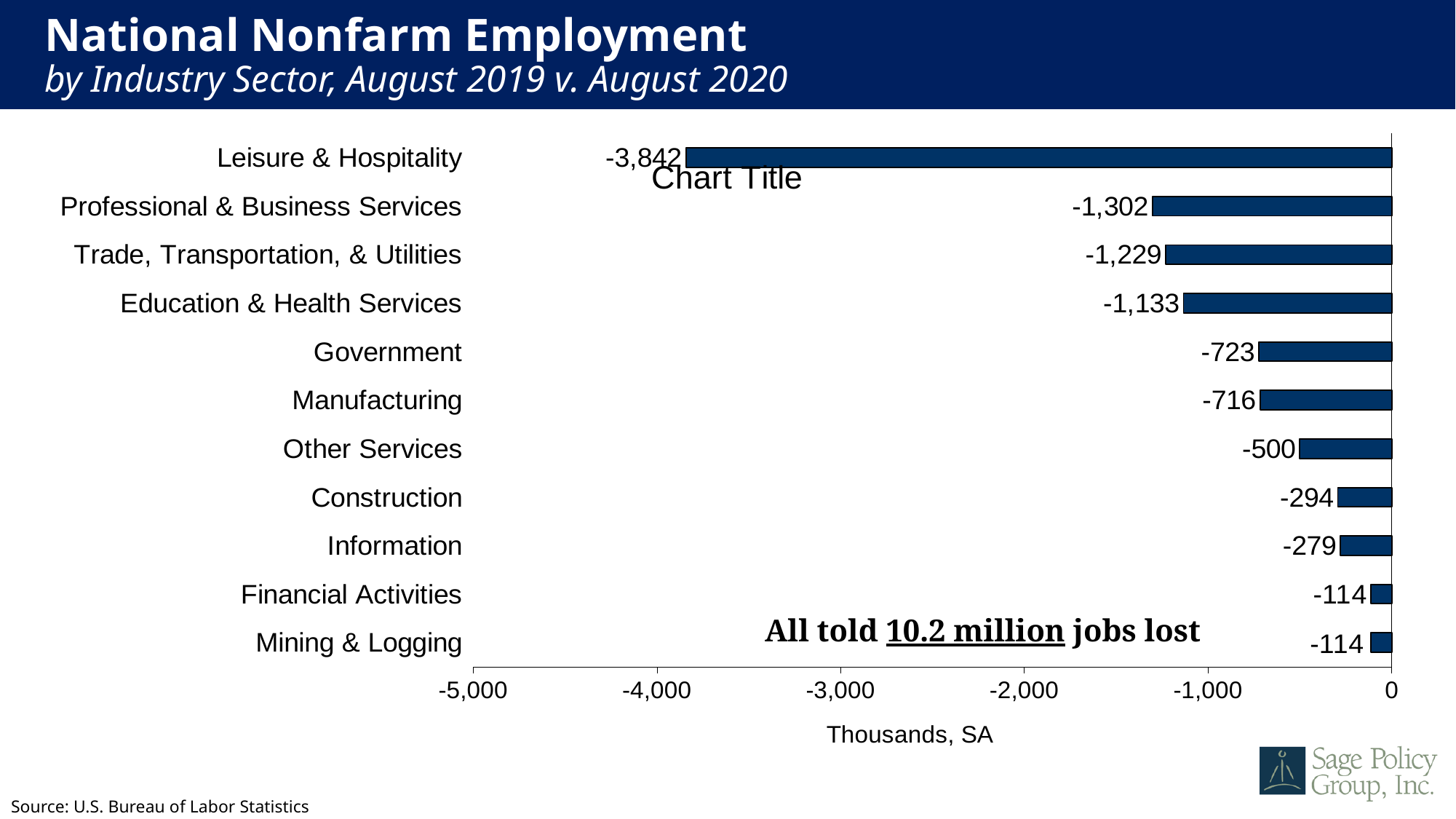
What is the value for Information? -279 How many industry sectors are shown in the chart? 11 What is the value for Leisure & Hospitality? -3,842 What is the label on the horizontal axis of the chart? Thousands, SA What is the value for Education & Health Services? -1,133 Is the value for Construction greater or less than -1,000? greater Which industry sector shows the largest job loss (the most negative value)? Leisure & Hospitality Which sector lost more jobs, Government or Manufacturing? Government What kind of chart is shown on the slide? bar chart What is the value for Other Services? -500 Which sectors show the smallest job loss (the value closest to zero)? Financial Activities and Mining & Logging What is the difference between the values for Leisure & Hospitality and Professional & Business Services? 2,540